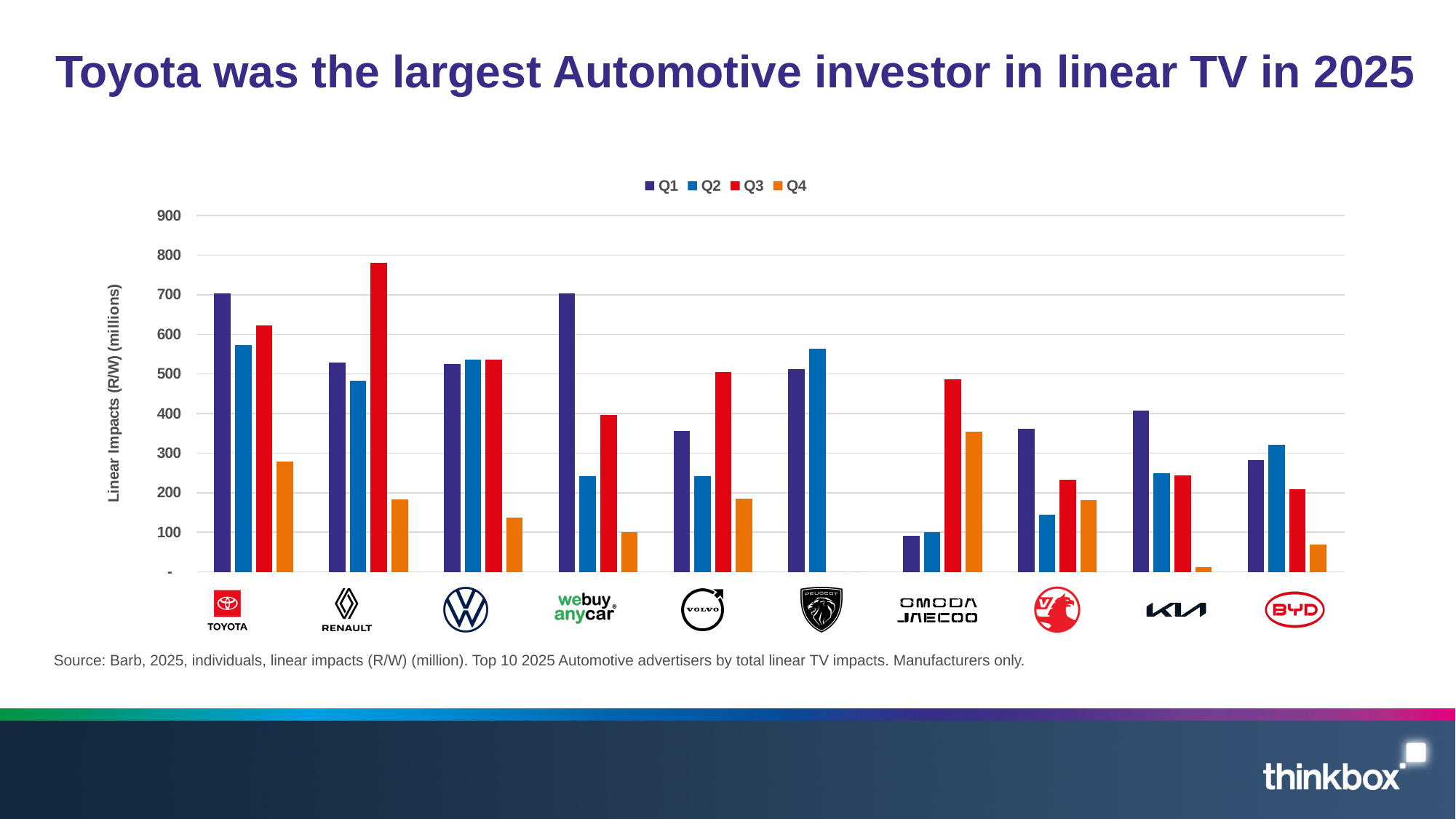
What kind of chart is shown on the slide? bar chart Is the Q4 value for Toyota greater or less than 300? less Which advertiser has the highest Q3 bar? Renault What is the label of the y axis? Linear Impacts (R/W) (millions) Which advertiser has the highest Q4 bar? Omoda Jaecoo How many advertisers (categories) are shown on the x axis? 10 How many series does the legend list? 4 Which is larger, the Q2 value for Toyota or the Q2 value for Renault? Toyota Is the Q3 value for Renault greater or less than 700? greater Is the Q2 value for Peugeot greater or less than 500? greater